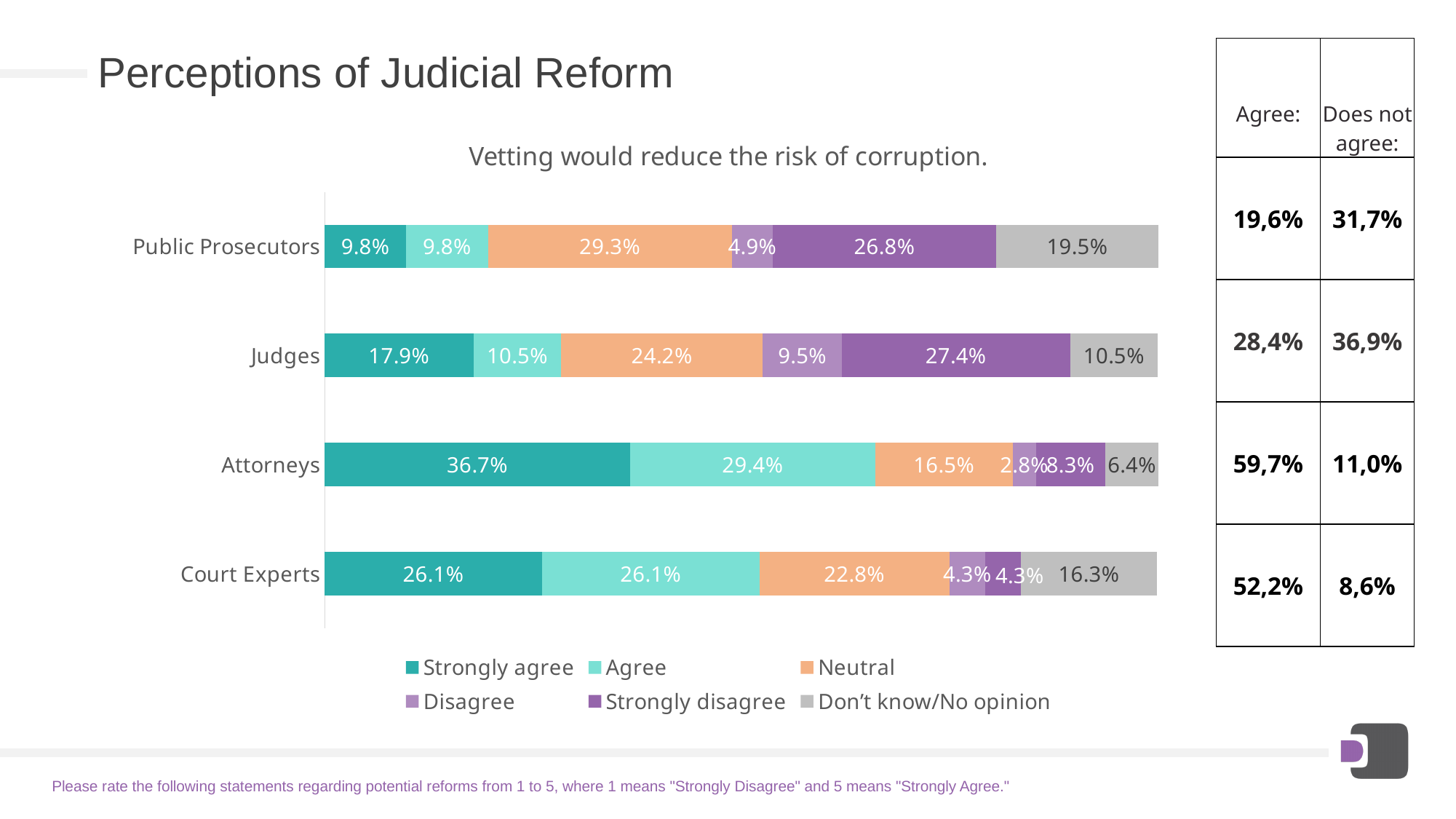
How many series does the legend list? 6 What is the difference in percentage points between the Neutral values for Public Prosecutors and Court Experts? 6.5 Which group has the highest Strongly agree value? Attorneys What is the Neutral value for Judges? 24.2% What type of chart is shown on the slide? Stacked bar chart What is the Strongly disagree value for Court Experts? 4.3% What is the difference in percentage points between the Strongly agree values for Attorneys and Judges? 18.8 What percentage of Attorneys strongly agree that vetting would reduce the risk of corruption? 36.7% How many groups are shown on the chart? 4 Which group has the lowest Strongly agree value? Public Prosecutors What is the Don't know/No opinion value for Public Prosecutors? 19.5% Which is larger, the Agree value for Attorneys or for Court Experts? Attorneys